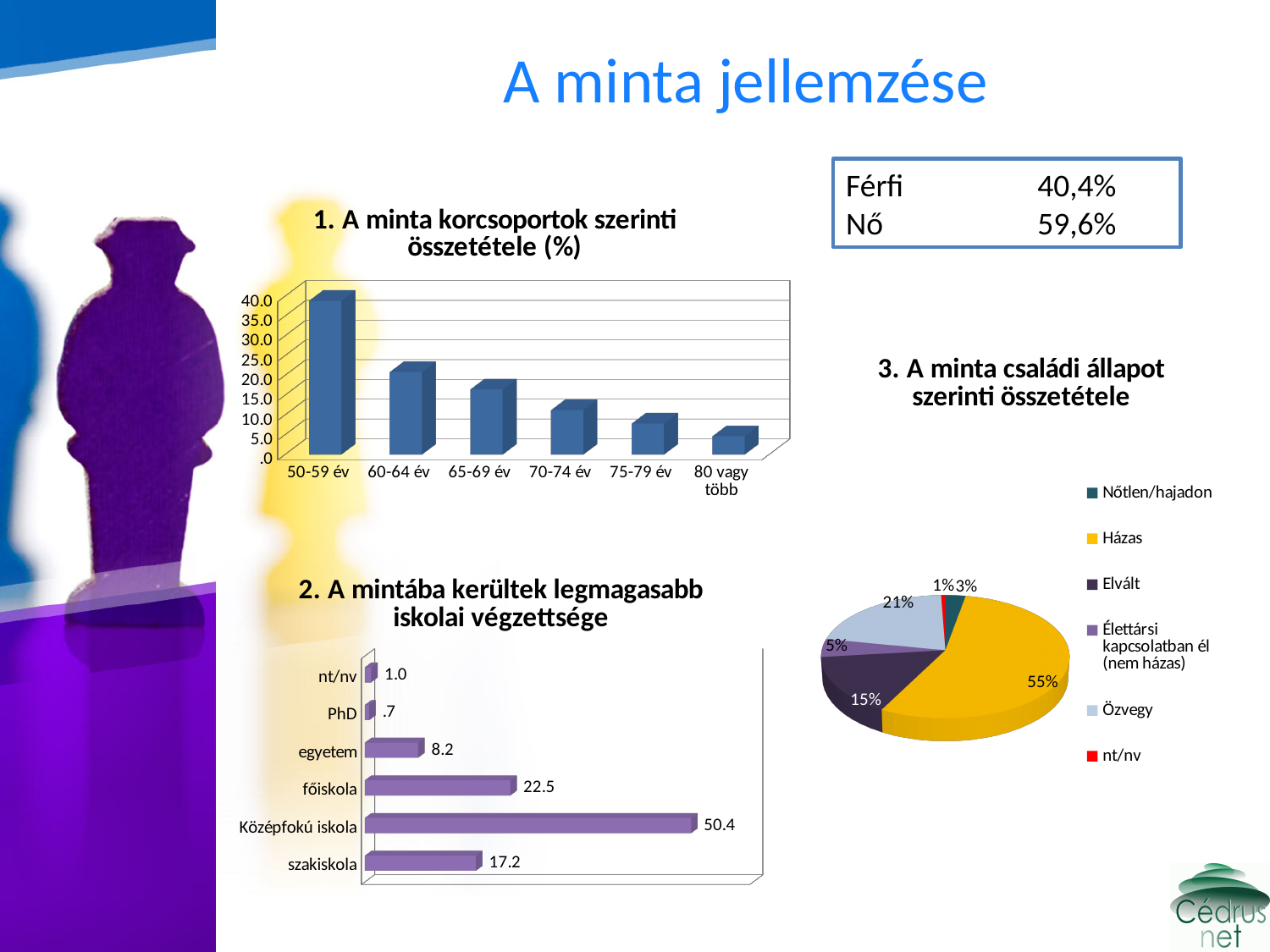
In chart 1 (A minta korcsoportok szerinti összetétele), which age group has the highest value? 50-59 év In chart 1 (A minta korcsoportok szerinti összetétele), what kind of chart is used? bar chart In chart 1 (A minta korcsoportok szerinti összetétele), is the value for 60-64 év greater or less than 15.0? greater In chart 2 (A mintába kerültek legmagasabb iskolai végzettsége), which category has the lowest value? PhD In chart 2 (A mintába kerültek legmagasabb iskolai végzettsége), how many categories are shown? 6 In chart 1 (A minta korcsoportok szerinti összetétele), do the values rise or fall from 50-59 év to 80 vagy több? fall In chart 3 (A minta családi állapot szerinti összetétele), how many entries does the legend list? 6 In chart 2 (A mintába kerültek legmagasabb iskolai végzettsége), what is the difference between the values for főiskola and szakiskola? 5.3 In chart 2 (A mintába kerültek legmagasabb iskolai végzettsége), what is the value for Középfokú iskola? 50.4 In chart 2 (A mintába kerültek legmagasabb iskolai végzettsége), what is the value for főiskola? 22.5 In chart 3 (A minta családi állapot szerinti összetétele), which is larger, Özvegy or Elvált? Özvegy In chart 3 (A minta családi állapot szerinti összetétele), what share of the pie is Házas? 55%